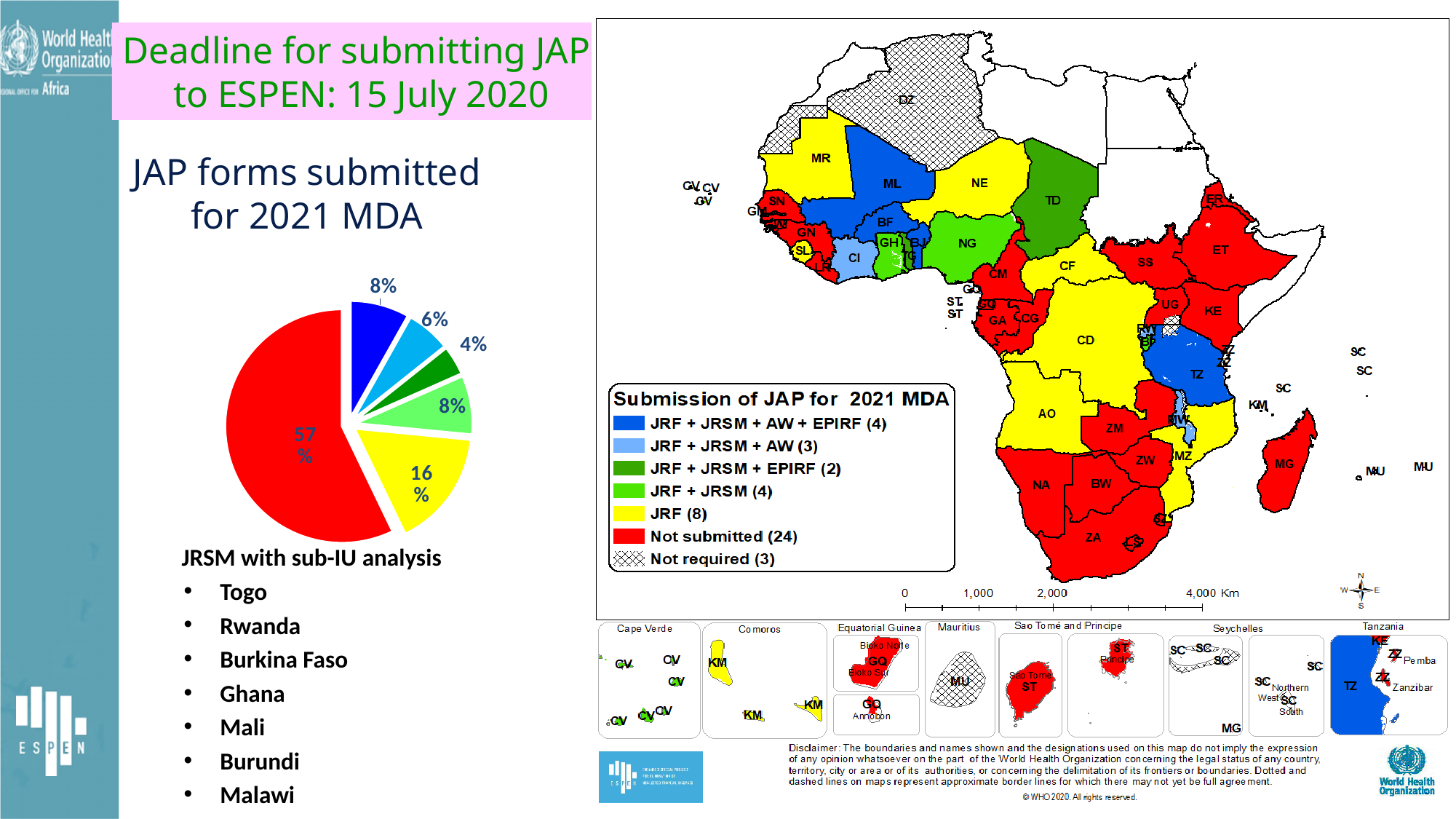
What kind of chart is shown under the heading 'JAP forms submitted for 2021 MDA'? pie chart In the pie chart 'JAP forms submitted for 2021 MDA', what is the difference in percentage points between the red slice (57%) and the yellow slice (16%)? 41 According to the map legend, how many countries are in the 'Not submitted' category? 24 In the pie chart 'JAP forms submitted for 2021 MDA', what share does the yellow slice represent? 16% In the pie chart 'JAP forms submitted for 2021 MDA', what is the combined share of the two slices labelled 8%? 16% How many slices does the pie chart 'JAP forms submitted for 2021 MDA' have? 6 What is the title of the pie chart on the left of the slide? JAP forms submitted for 2021 MDA In the pie chart 'JAP forms submitted for 2021 MDA', what share does the red slice represent? 57% In the pie chart 'JAP forms submitted for 2021 MDA', what is the share of the smallest slice? 4% In the pie chart 'JAP forms submitted for 2021 MDA', which slice is larger, the yellow slice or the dark blue slice? yellow slice In the pie chart 'JAP forms submitted for 2021 MDA', what share does the light blue slice represent? 6% In the pie chart 'JAP forms submitted for 2021 MDA', what is the share of the largest slice? 57%